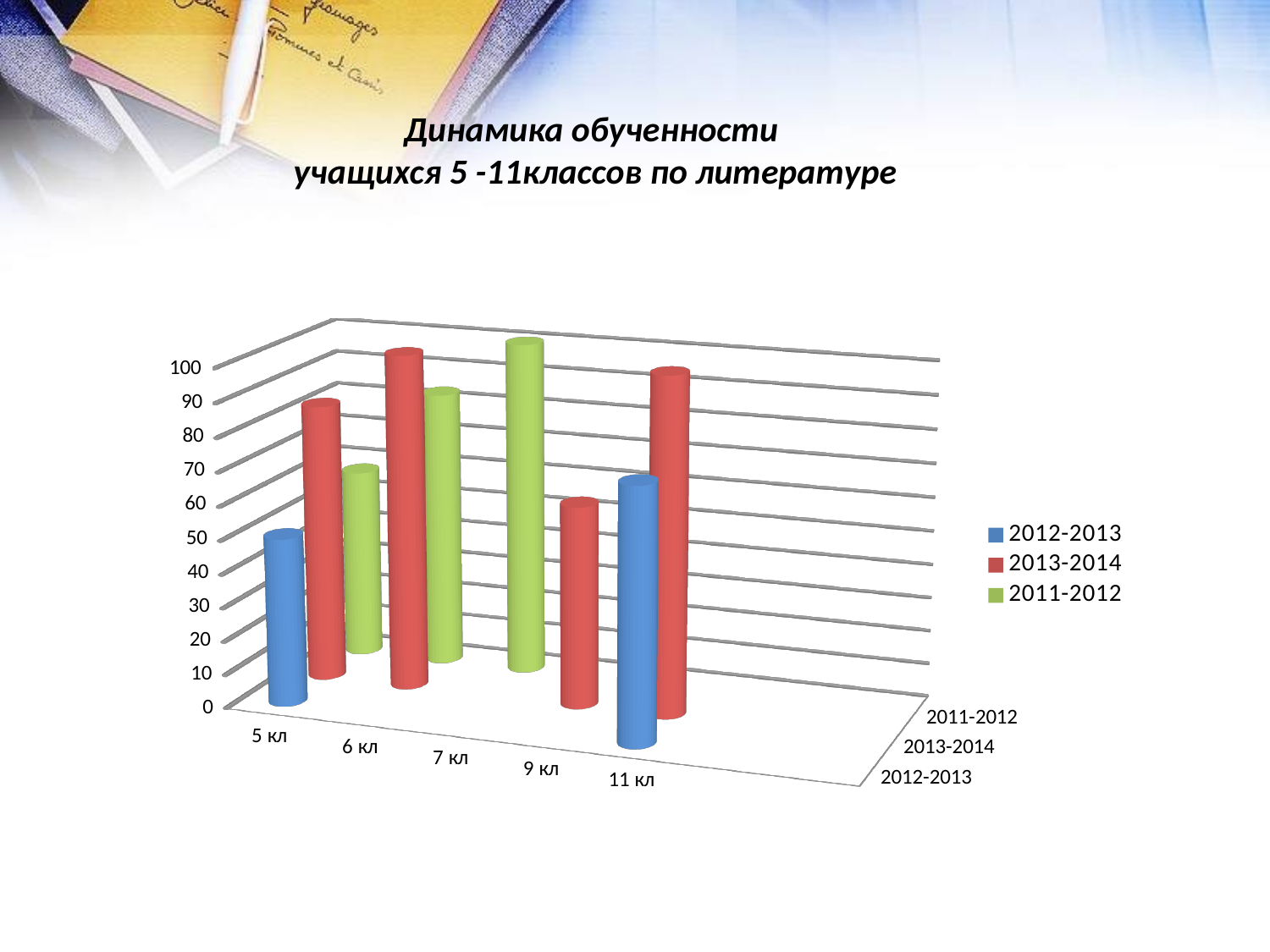
Is the 2012-2013 value for 5 кл greater or less than 80? less Which series is shown in blue according to the legend? 2012-2013 Which series is shown in green according to the legend? 2011-2012 Which is larger: the 2013-2014 value for 11 кл or the 2013-2014 value for 9 кл? 2013-2014 value for 11 кл Is the 2013-2014 value for 9 кл greater or less than 90? less How many class categories are shown along the x axis? 5 Which is larger: the 2013-2014 value for 6 кл or the 2012-2013 value for 5 кл? 2013-2014 value for 6 кл Is the 2013-2014 value for 6 кл greater or less than 70? greater How many series does the legend list? 3 Among the 2012-2013 bars, which class has the higher value? 11 кл What kind of chart is shown on the slide? bar chart